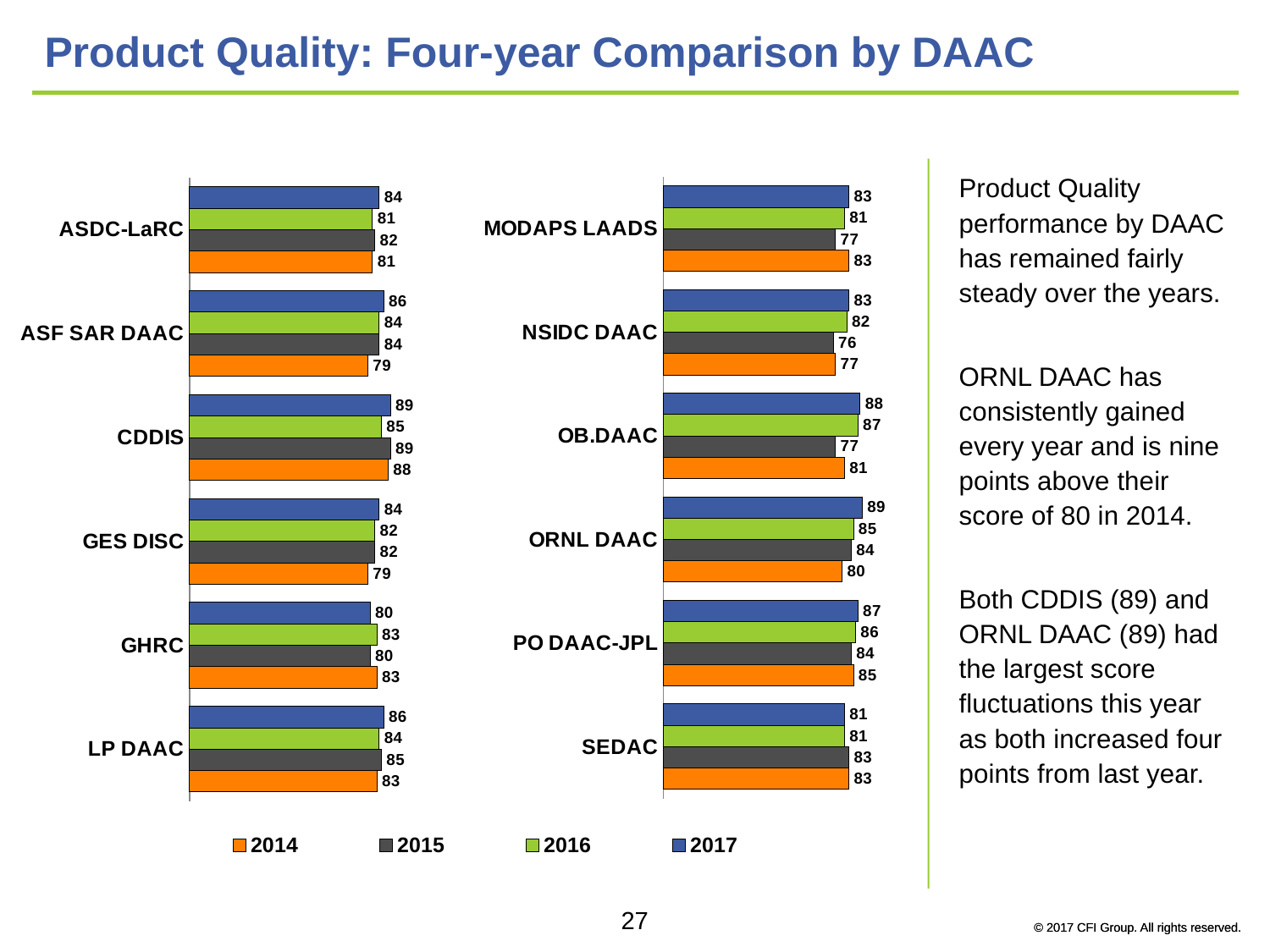
How many DAACs are shown in the left chart? 6 In the right chart, what is the 2015 value for NSIDC DAAC? 76 In the right chart, what is the difference between the 2017 and 2014 values for ORNL DAAC? 9 In the right chart, what is the 2016 value for OB.DAAC? 87 In the left chart, what is the 2014 value for ASF SAR DAAC? 79 In the right chart, which DAAC has the highest 2017 value? ORNL DAAC What kind of chart is the right chart? Bar chart In the left chart, what is the difference between the 2017 and 2016 values for CDDIS? 4 How many series does the legend list? 4 In the left chart, what is the 2017 value for CDDIS? 89 In the right chart, which is larger for MODAPS LAADS: the 2016 value or the 2015 value? 2016 In the left chart, which DAAC has the lowest 2017 value? GHRC